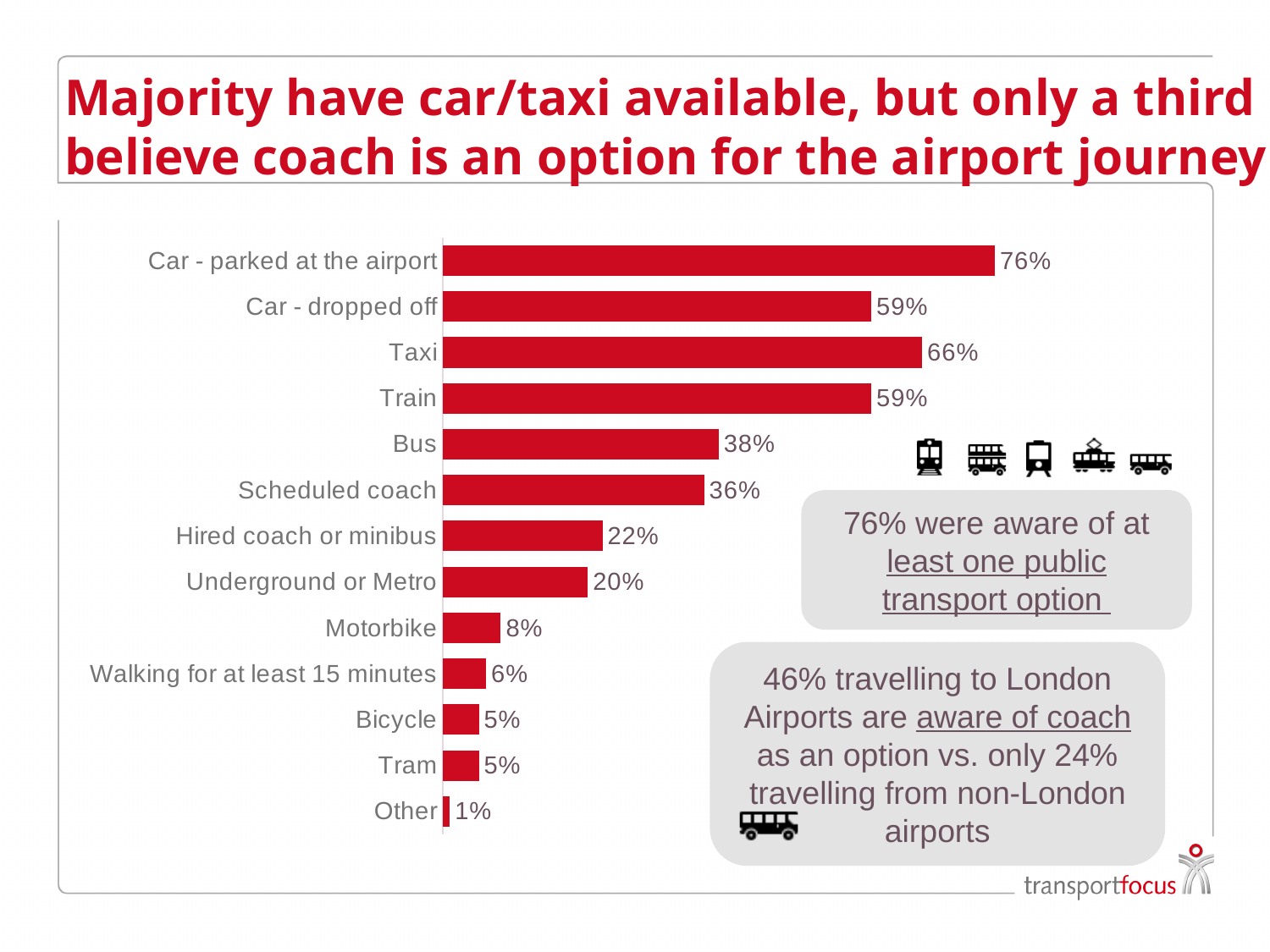
What kind of chart is shown on the slide? Bar chart What is the value for Scheduled coach? 36% Which category has the lowest value? Other What is the difference between the values for Taxi and Bus? 28% What is the value for Underground or Metro? 20% What is the value for Car - parked at the airport? 76% Which category has the highest value? Car - parked at the airport What is the difference between the values for Car - parked at the airport and Car - dropped off? 17% What is the value for Walking for at least 15 minutes? 6% Which is larger, the value for Hired coach or minibus or the value for Motorbike? Hired coach or minibus How many categories are shown in the chart? 13 What colour are the bars in the chart? Red